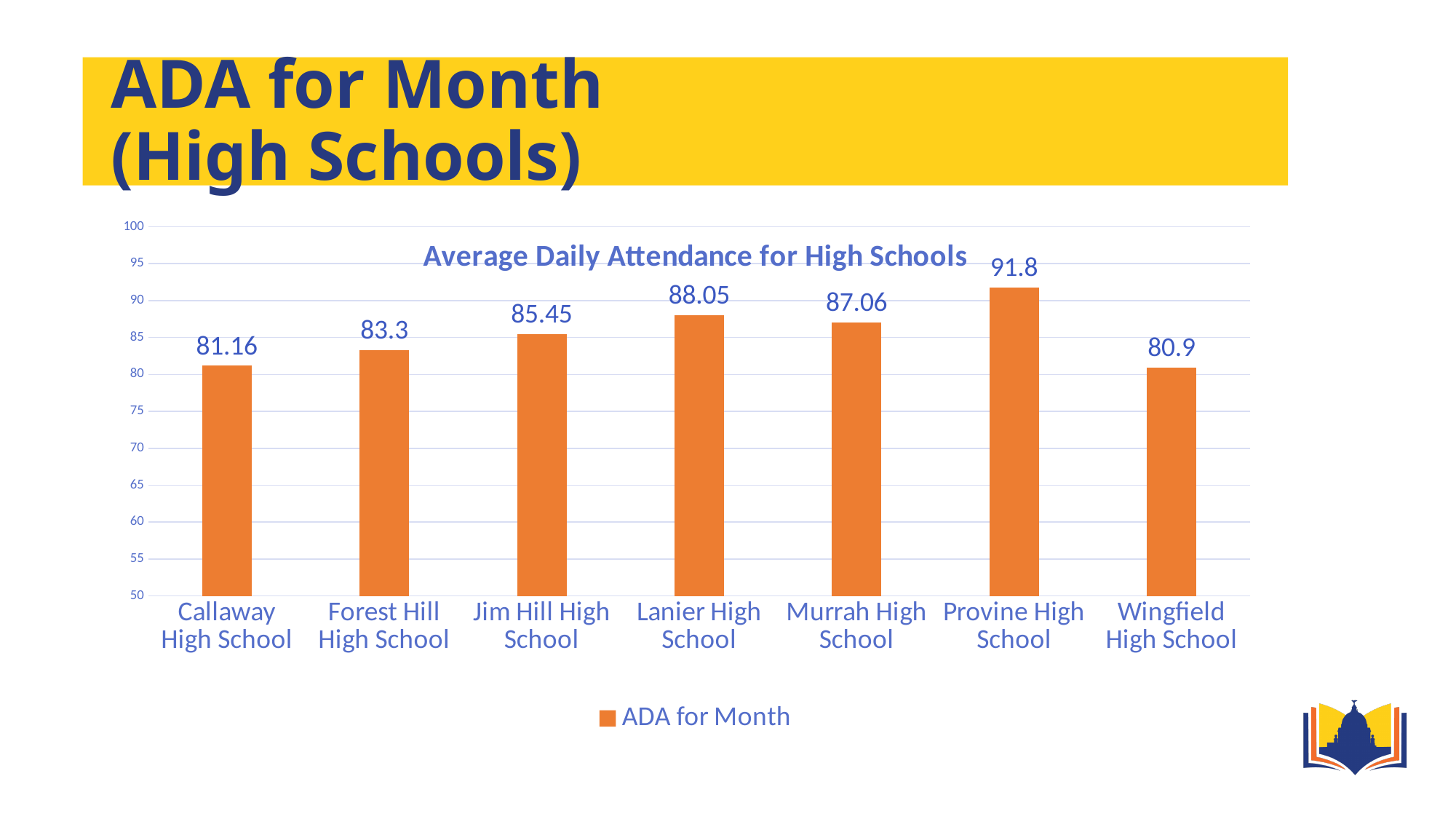
Which has a higher ADA for Month, Murrah High School or Forest Hill High School? Murrah High School How many high schools are shown in the chart? 7 What is the ADA for Month value for Lanier High School? 88.05 Which high school has the lowest ADA for Month? Wingfield High School What kind of chart is shown on the slide? Bar chart Which high school has the highest ADA for Month? Provine High School What is the title of the chart? Average Daily Attendance for High Schools What is the difference between the ADA for Month of Provine High School and Callaway High School? 10.64 Is the value for Jim Hill High School greater or less than 90? less What is the ADA for Month value for Wingfield High School? 80.9 How many series does the legend list? 1 What is the legend entry shown below the chart? ADA for Month